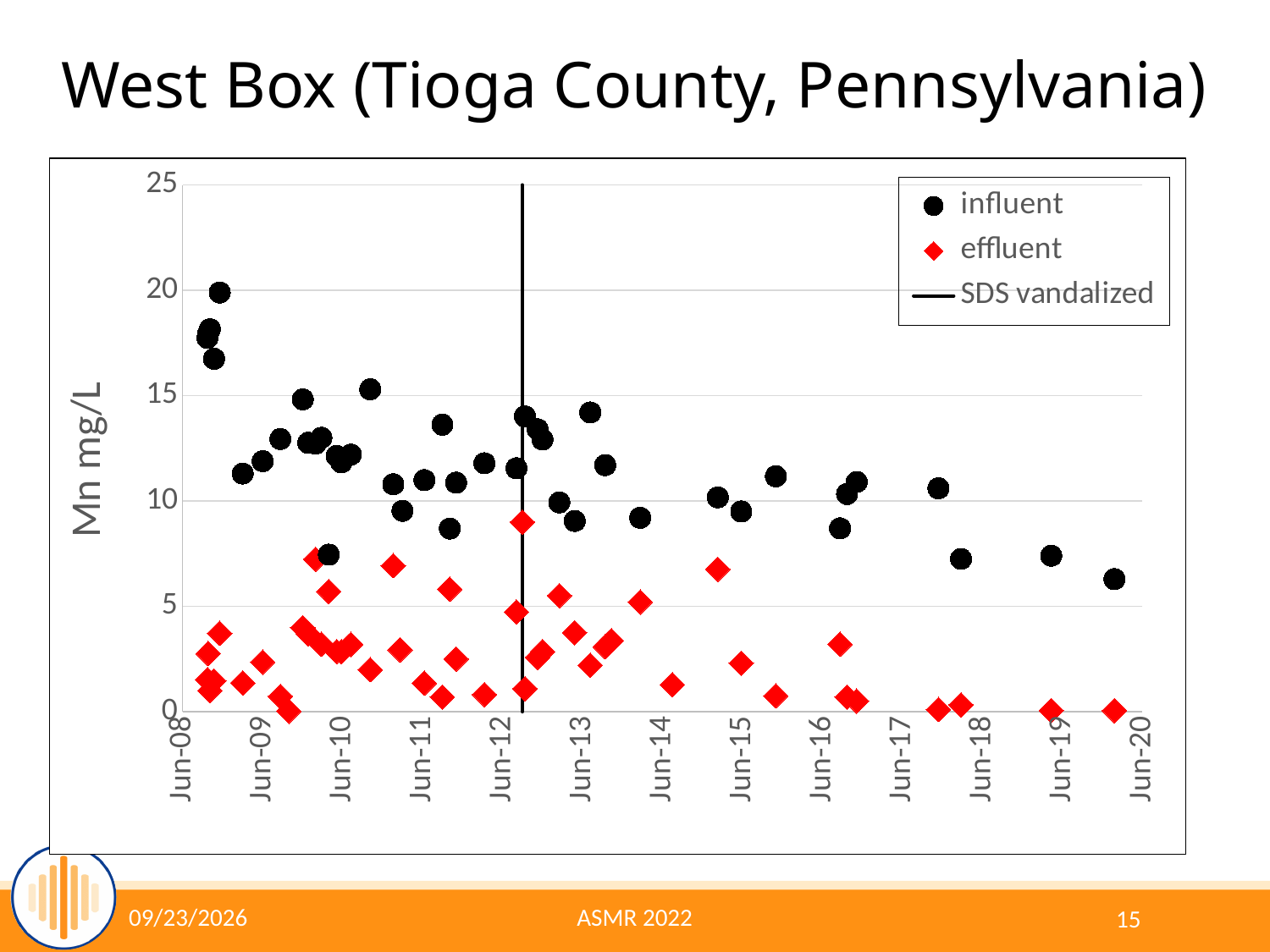
How many entries does the legend list? 3 Which series contains the highest plotted value, influent or effluent? influent Is the highest influent value, plotted near Jun-08, greater or less than 15? greater Near Jun-19, which is larger, the influent value or the effluent value? influent Is the highest effluent value greater or less than 10? less Which series contains the lowest plotted values, influent or effluent? effluent Is the influent value plotted near Jun-20 greater or less than 10? less Do the influent values generally rise or fall from Jun-08 to Jun-20? fall What does the vertical black line in the chart represent, according to the legend? SDS vandalized What is the label on the y axis? Mn mg/L What kind of chart is shown on the slide? scatter chart